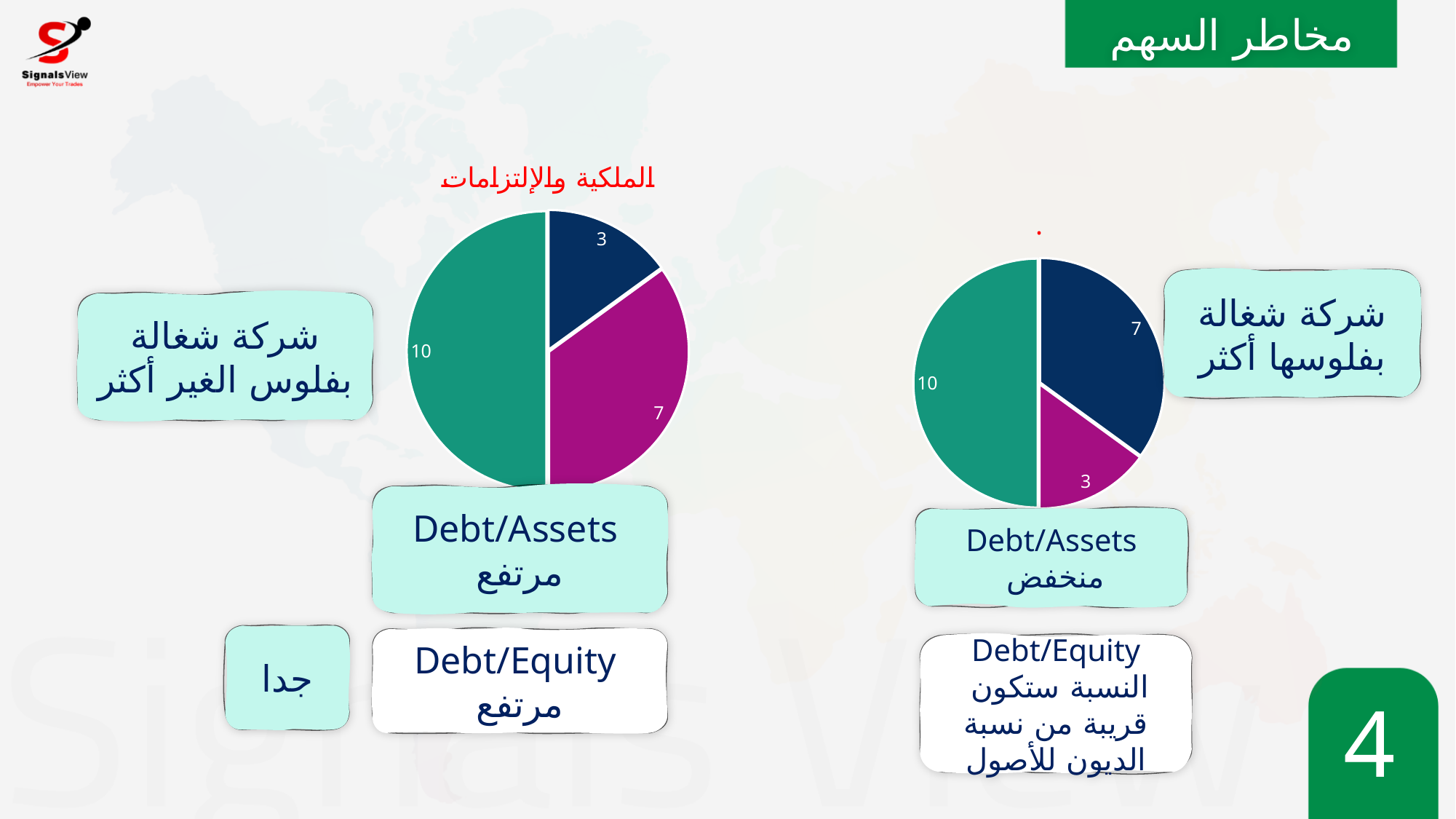
In the left pie chart, what is the value of the largest slice? 10 How many slices does the left pie chart have? 3 In the left pie chart, what is the difference between the teal slice and the magenta slice? 3 In the right pie chart, what is the value of the dark blue slice? 7 In the right pie chart, which is larger, the dark blue slice or the magenta slice? dark blue slice What is the title shown above the left pie chart? الملكية والإلتزامات In the left pie chart, what share of the whole does the teal slice (10) represent? 50% In the left pie chart, what is the total of all slices? 20 What kind of chart is the left chart titled "الملكية والإلتزامات"? pie chart In the left pie chart, what is the value of the dark blue slice? 3 In the left pie chart, what is the value of the magenta slice? 7 In the left pie chart, what is the value of the smallest slice? 3